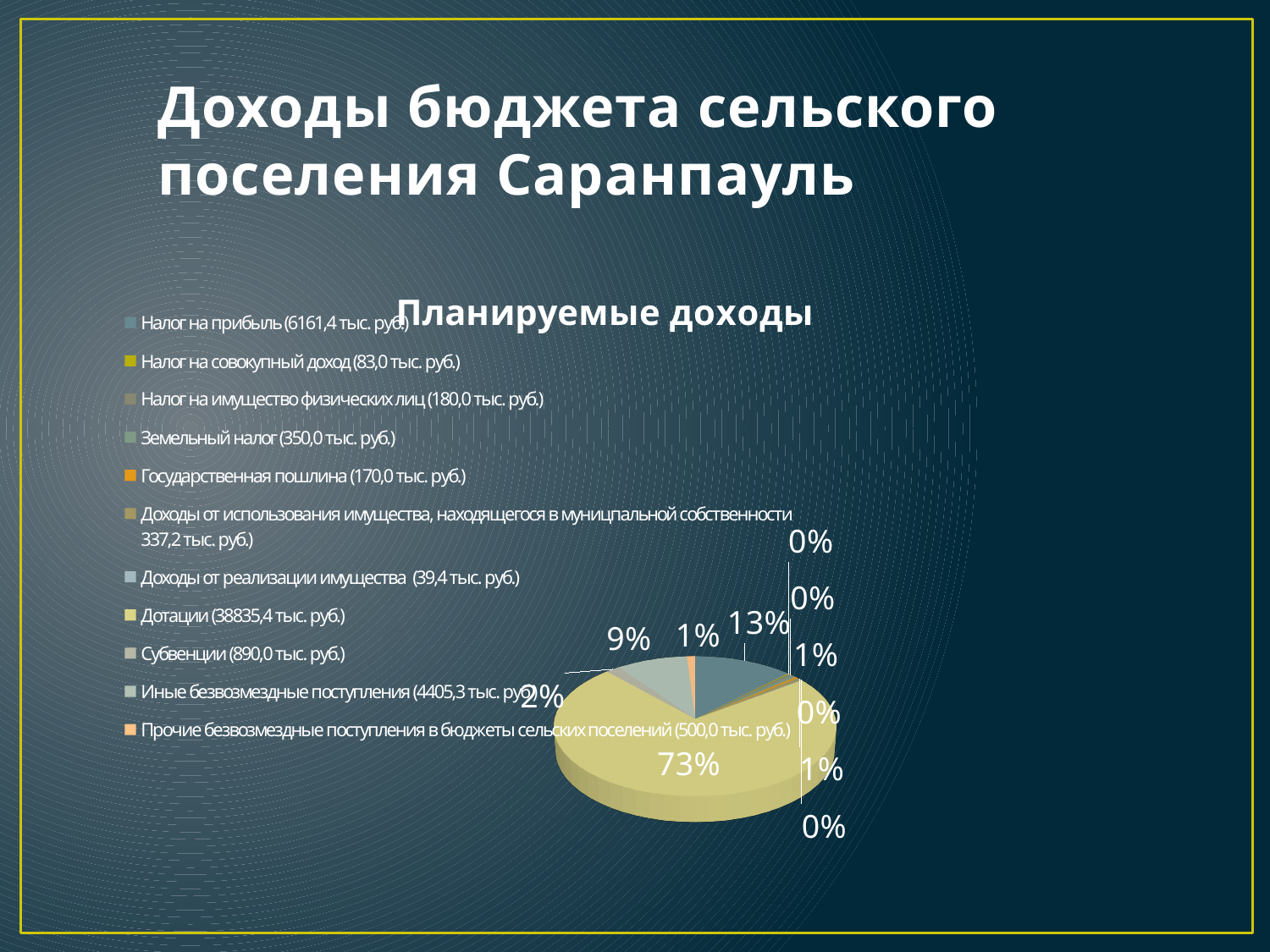
What is the difference in percentage points between the 73% slice and the 13% slice? 60 What amount is shown in the legend for Дотации? 38835,4 тыс. руб. What is the smallest percentage value labelled on the pie chart? 0% Is the share of the largest slice greater or less than 50%? greater What is the largest share shown on the pie chart? 73% What amount is shown in the legend for Налог на прибыль? 6161,4 тыс. руб. How many entries does the chart's legend list? 11 Which category has the largest slice of the pie chart? Дотации What is the title of the chart on the slide? Планируемые доходы Which is larger: the 9% slice or the 13% slice? 13% What kind of chart is shown on the slide? Pie chart What is the second-largest percentage label shown on the pie chart? 13%